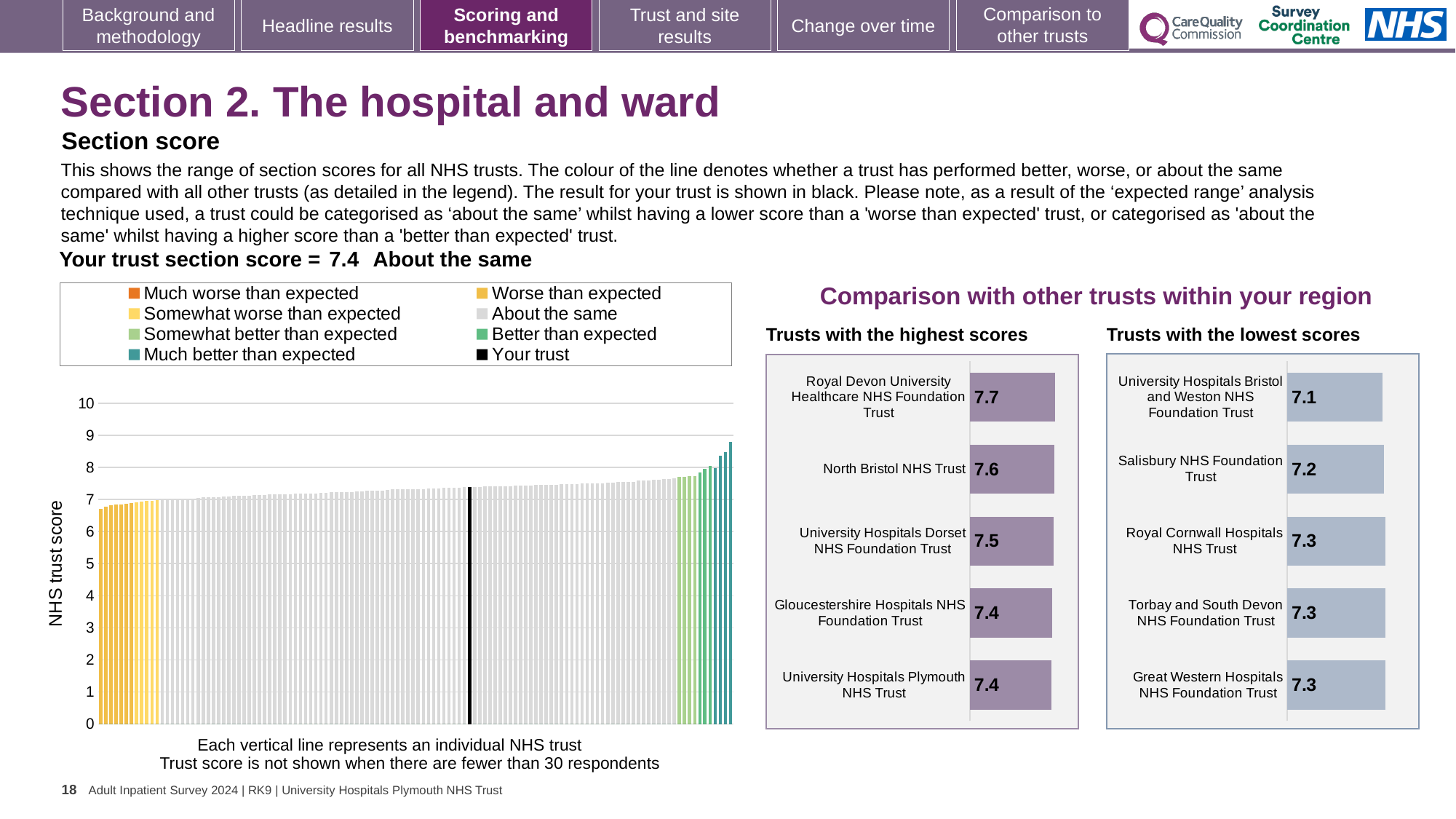
In the 'Trusts with the highest scores' chart, which trust has the highest score? Royal Devon University Healthcare NHS Foundation Trust In the 'Trusts with the lowest scores' chart, which trust has the lowest score? University Hospitals Bristol and Weston NHS Foundation Trust In the 'Trusts with the lowest scores' chart, which has the larger score: University Hospitals Bristol and Weston NHS Foundation Trust or Royal Cornwall Hospitals NHS Trust? Royal Cornwall Hospitals NHS Trust In the main chart of NHS trust scores on the left, do the values rise or fall from left to right? rise In the 'Trusts with the highest scores' chart, what is the score for Royal Devon University Healthcare NHS Foundation Trust? 7.7 In the 'Trusts with the highest scores' chart, what is the score for North Bristol NHS Trust? 7.6 How many entries does the legend of the main chart on the left list? 8 In the 'Trusts with the highest scores' chart, what is the difference between the scores of Royal Devon University Healthcare NHS Foundation Trust and University Hospitals Plymouth NHS Trust? 0.3 In the main chart of NHS trust scores on the left, is the value of the leftmost (lowest) bar greater or less than 7? less How many trusts are shown in the 'Trusts with the lowest scores' chart? 5 In the 'Trusts with the lowest scores' chart, what is the score for Salisbury NHS Foundation Trust? 7.2 In the main chart of NHS trust scores on the left, what is the section score for your trust? 7.4